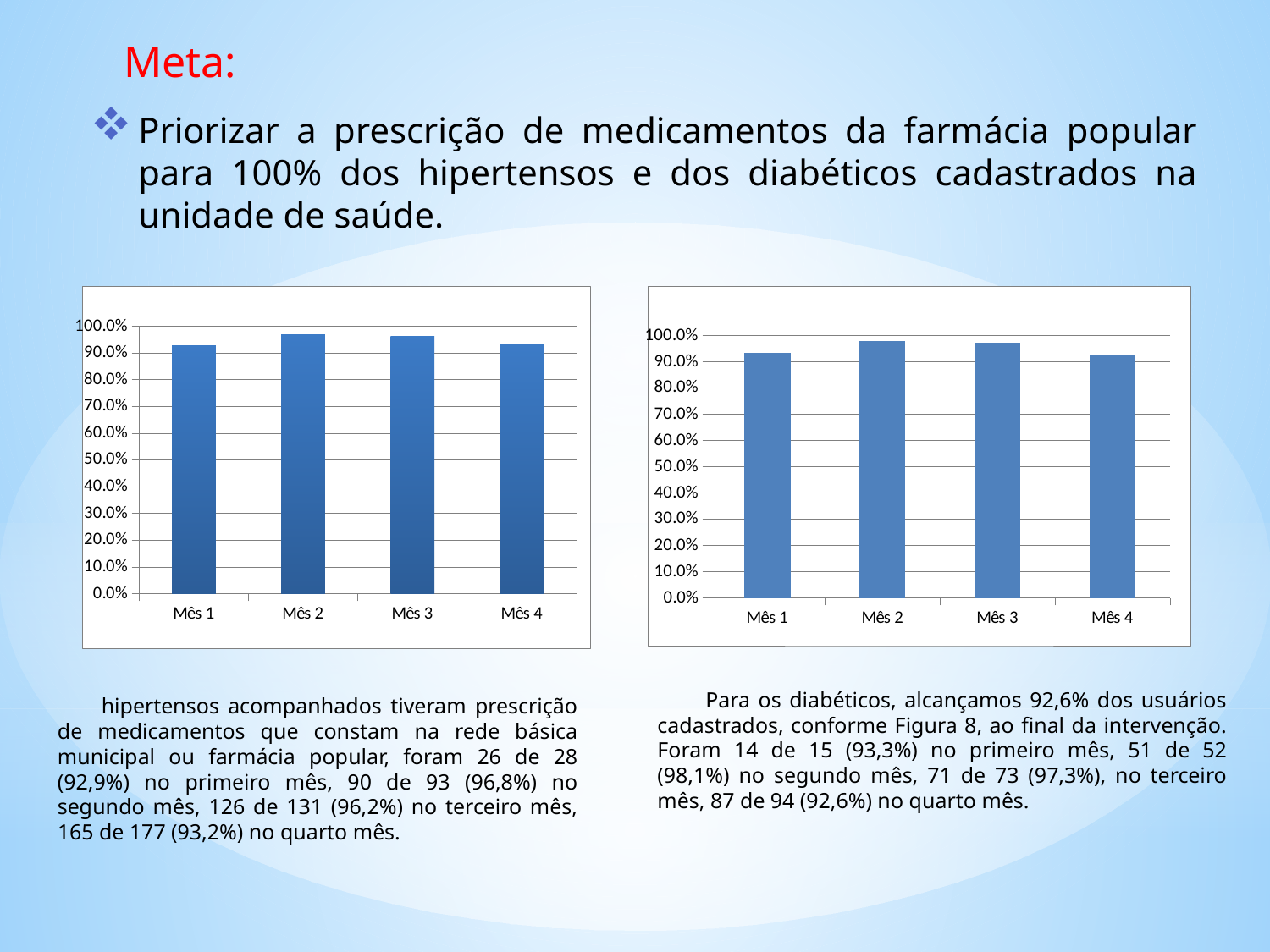
In the right chart, which is larger, the value for Mês 2 or the value for Mês 4? Mês 2 In the right chart, is the value for Mês 3 greater or less than 100.0%? less What is the label of the first category on the x axis of the left chart? Mês 1 How many bars does the right chart have? 4 In the right chart, which is larger, the value for Mês 1 or the value for Mês 3? Mês 3 In the left chart, is the value for Mês 2 greater or less than 100.0%? less In the right chart, is the value for Mês 4 greater or less than 90.0%? greater In the left chart, which is larger, the value for Mês 1 or the value for Mês 2? Mês 2 What kind of chart is the right chart on the slide? bar chart How many categories are shown on the x axis of the left chart? 4 What kind of chart is the left chart on the slide? bar chart